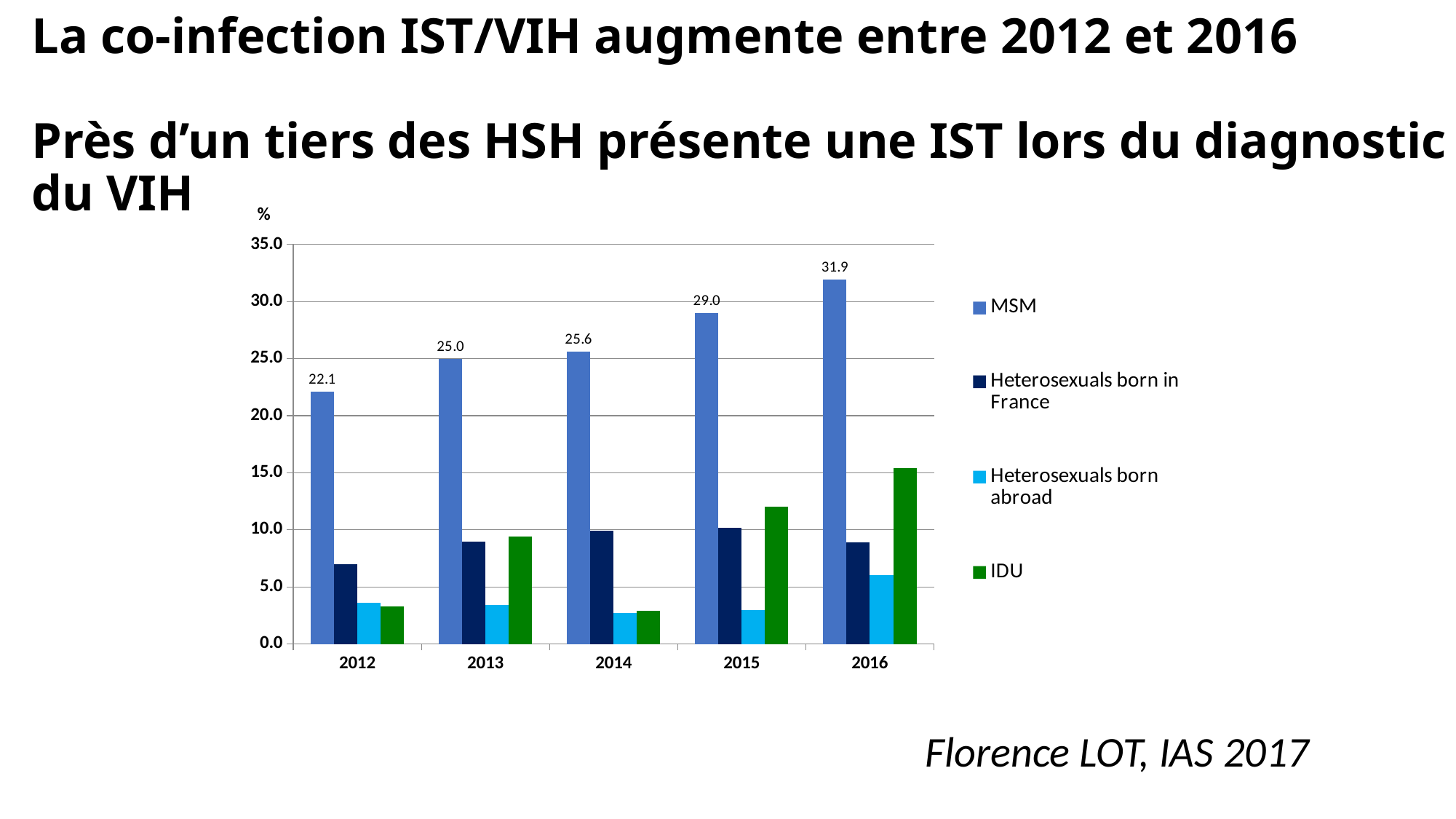
In which year is the MSM value highest? 2016 Is the value for IDU in 2016 greater or less than 10? greater What is the value for MSM in 2014? 25.6 What is the difference between the MSM values for 2016 and 2012? 9.8 What is the value for MSM in 2016? 31.9 Is the value for Heterosexuals born abroad in 2016 greater or less than 10? less Do the MSM values rise or fall from 2012 to 2016? rise In which year is the MSM value lowest? 2012 Which is larger, the MSM value for 2015 or for 2013? 2015 How many series does the legend list? 4 How many years are shown on the x axis? 5 What is the value for MSM in 2012? 22.1